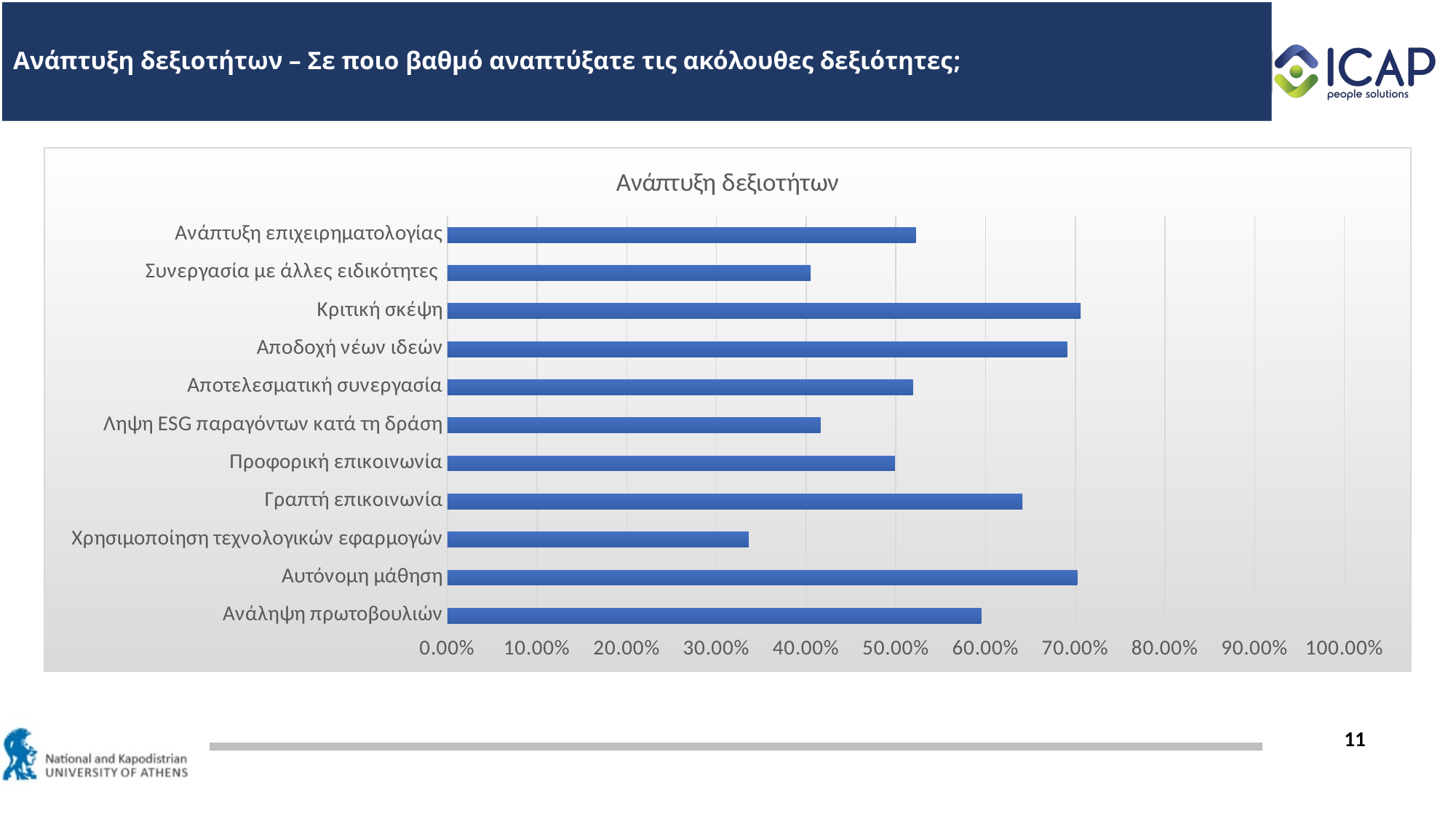
What kind of chart is shown on the slide? Bar chart How many skill categories are plotted in the chart? 11 Is the value for Ληψη ESG παραγόντων κατά τη δράση greater or less than 50.00%? less Is the value for Συνεργασία με άλλες ειδικότητες greater or less than 50.00%? less Is the value for Χρησιμοποίηση τεχνολογικών εφαρμογών greater or less than 40.00%? less What is the maximum value shown on the horizontal axis of the chart? 100.00% What is the title of the chart? Ανάπτυξη δεξιοτήτων Which is larger, the value for Γραπτή επικοινωνία or the value for Προφορική επικοινωνία? Γραπτή επικοινωνία Which category has the lowest value in the chart? Χρησιμοποίηση τεχνολογικών εφαρμογών Which is larger, the value for Αποδοχή νέων ιδεών or the value for Συνεργασία με άλλες ειδικότητες? Αποδοχή νέων ιδεών